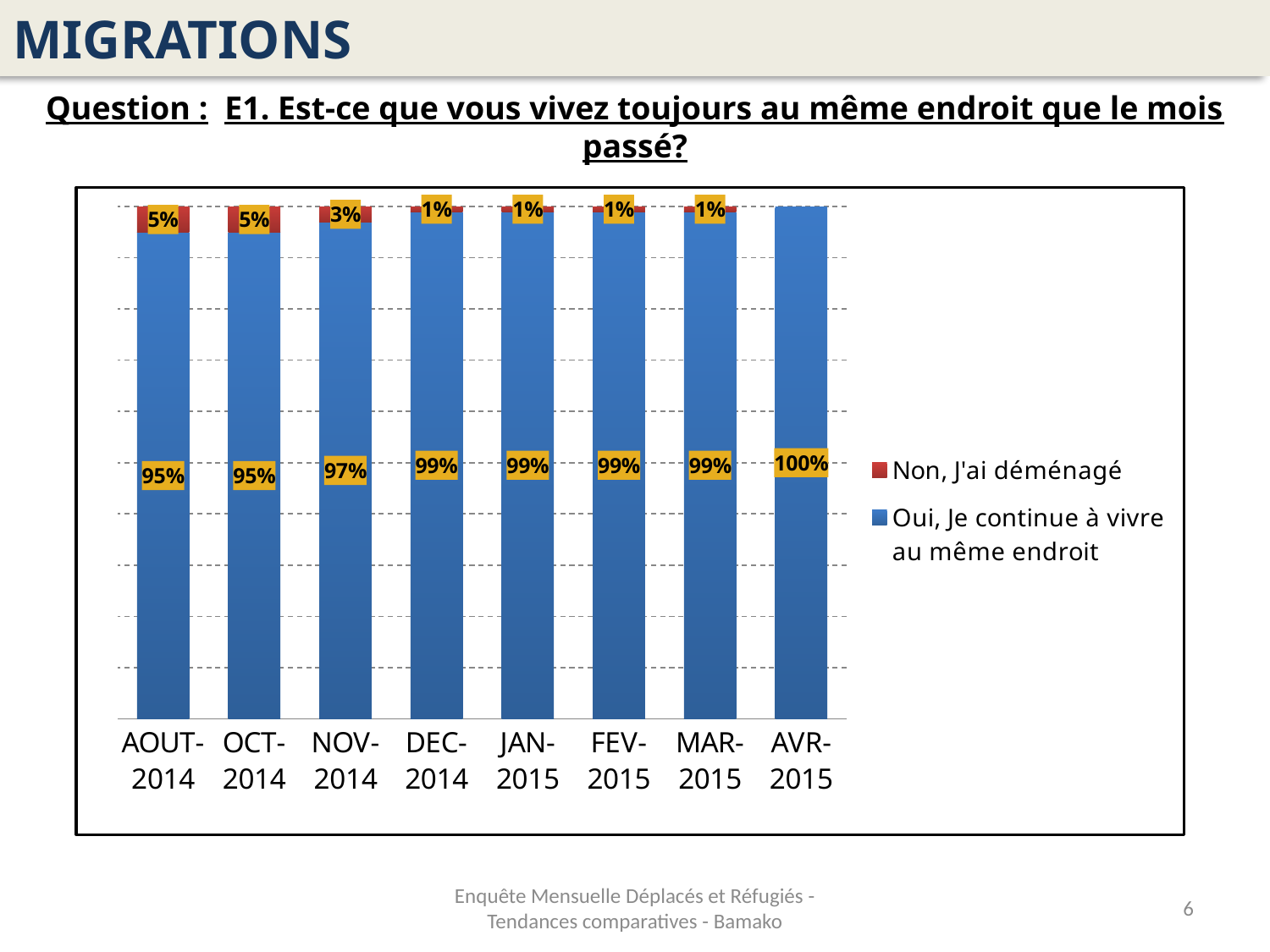
What is the value for "Non, J'ai déménagé" in DEC-2014? 1% How many series does the legend list? 2 Which is larger: the "Non, J'ai déménagé" value in OCT-2014 or in NOV-2014? OCT-2014 What kind of chart is shown on the slide? Stacked bar chart What percentage of respondents in AOUT-2014 said "Oui, Je continue à vivre au même endroit"? 95% Which month has the lowest value for "Oui, Je continue à vivre au même endroit"? AOUT-2014 and OCT-2014 (95%) What is the difference between the "Oui" value in AVR-2015 and the "Oui" value in AOUT-2014? 5% What is the value for "Oui, Je continue à vivre au même endroit" in AVR-2015? 100% What is the value for "Non, J'ai déménagé" in NOV-2014? 3% Does the "Oui, Je continue à vivre au même endroit" series rise or fall from AOUT-2014 to AVR-2015? Rise How many months are shown on the x axis? 8 Which month has the highest value for "Oui, Je continue à vivre au même endroit"? AVR-2015